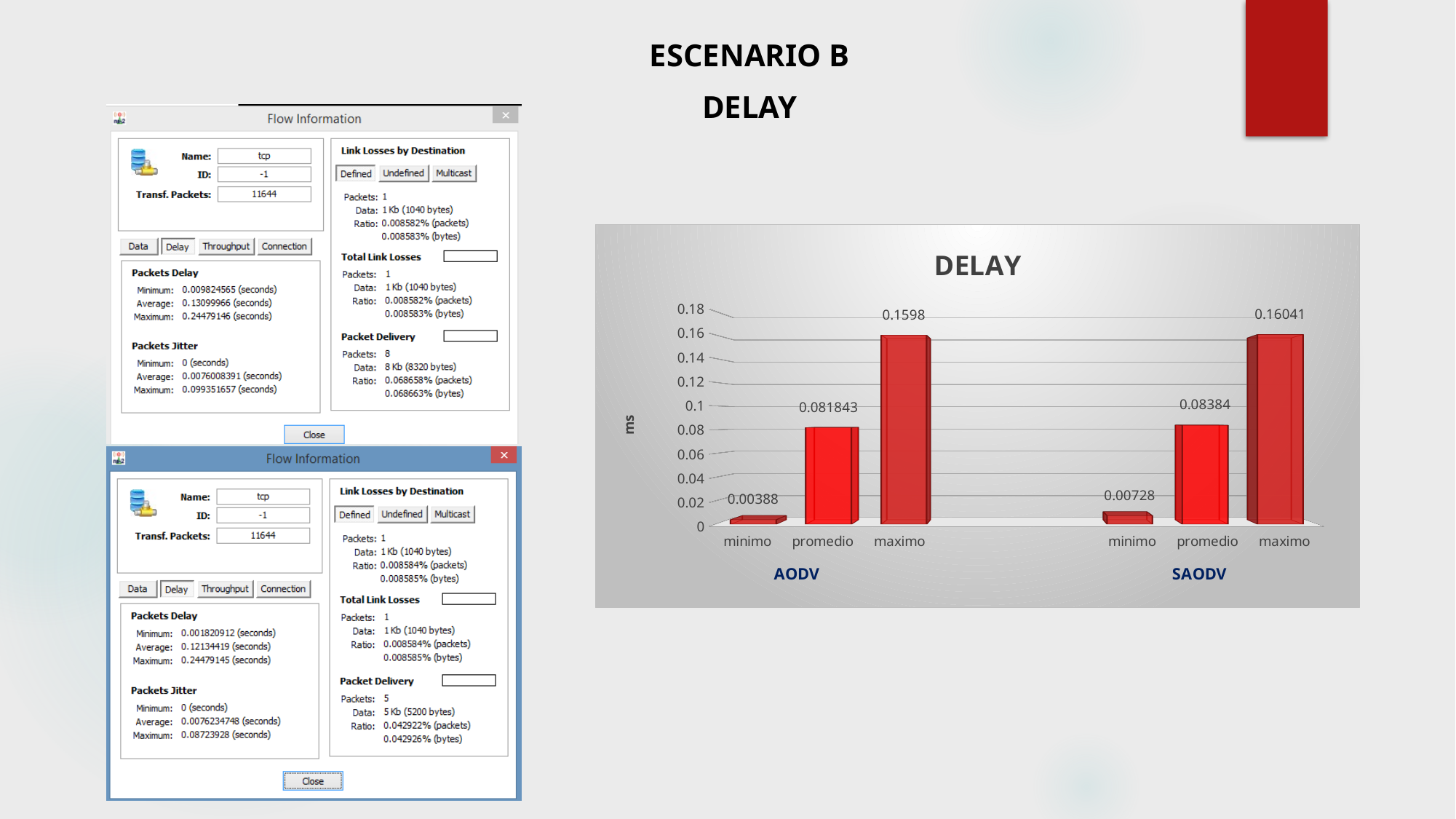
What is the difference between the SAODV minimo and AODV minimo values in the DELAY chart? 0.0034 Which bar has the highest value in the DELAY chart? SAODV maximo What type of chart is the DELAY chart? bar chart What is the value of the maximo bar for AODV in the DELAY chart? 0.1598 What unit is shown on the vertical axis of the DELAY chart? ms Is the promedio value for AODV in the DELAY chart greater or less than 0.1? less How many bars are plotted in the DELAY chart? 6 What is the value of the minimo bar for AODV in the DELAY chart? 0.00388 What is the value of the promedio bar for SAODV in the DELAY chart? 0.08384 What is the value of the minimo bar for SAODV in the DELAY chart? 0.00728 Which bar has the lowest value in the DELAY chart? AODV minimo Which is larger in the DELAY chart, the promedio value for AODV or the promedio value for SAODV? SAODV